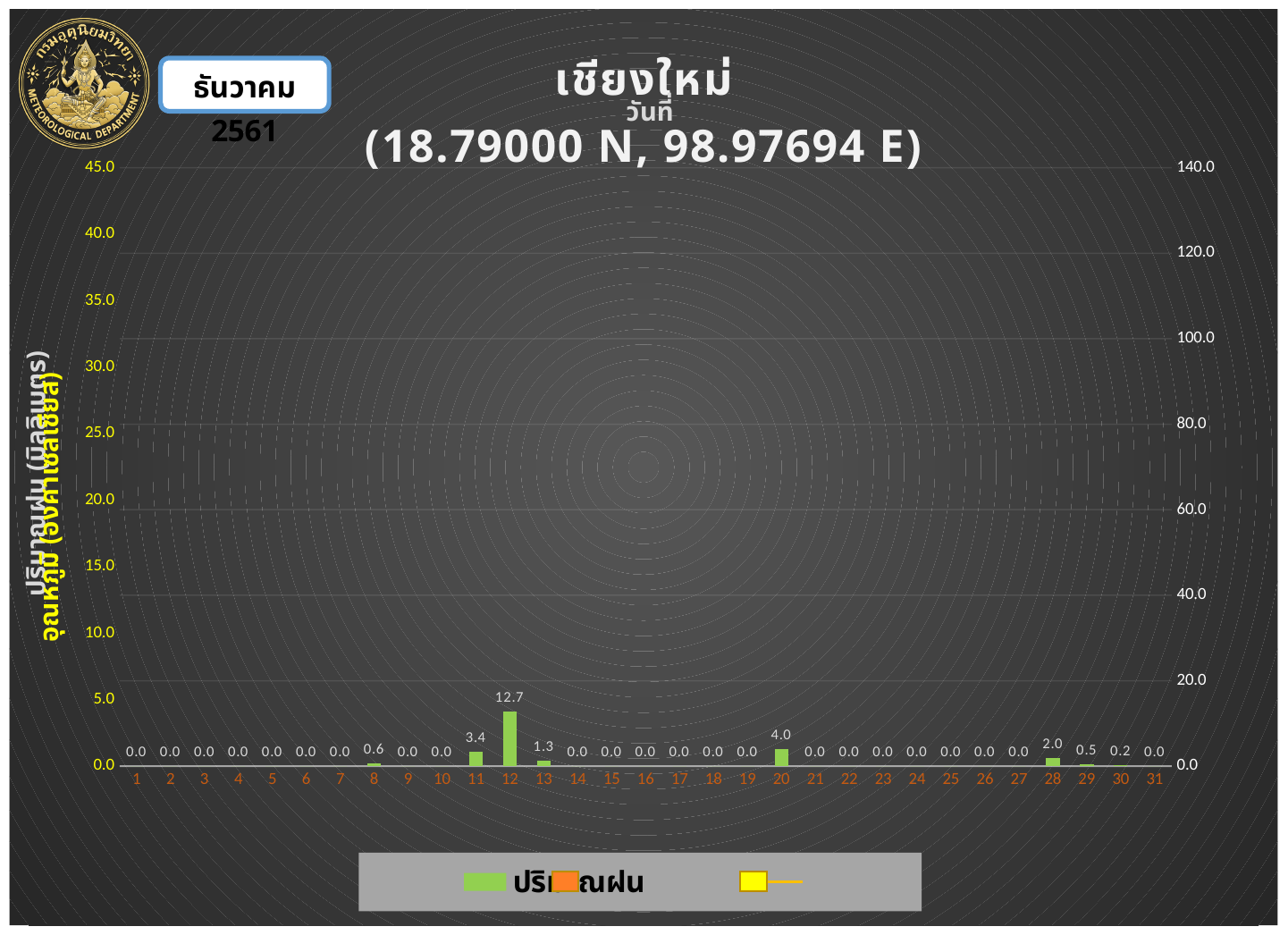
What is the value for day 11? 3.4 Which day has the highest value? 12 What coordinates are shown in the chart title? 18.79000 N, 98.97694 E What is the value for day 12? 12.7 What kind of chart is this? bar chart Which is larger, the value for day 11 or the value for day 13? day 11 How many days are shown on the x axis? 31 What is the value for day 28? 2.0 What is the difference between the values for day 12 and day 20? 8.7 What is the value for day 20? 4.0 What is the value for day 8? 0.6 What is the difference between the values for day 28 and day 29? 1.5